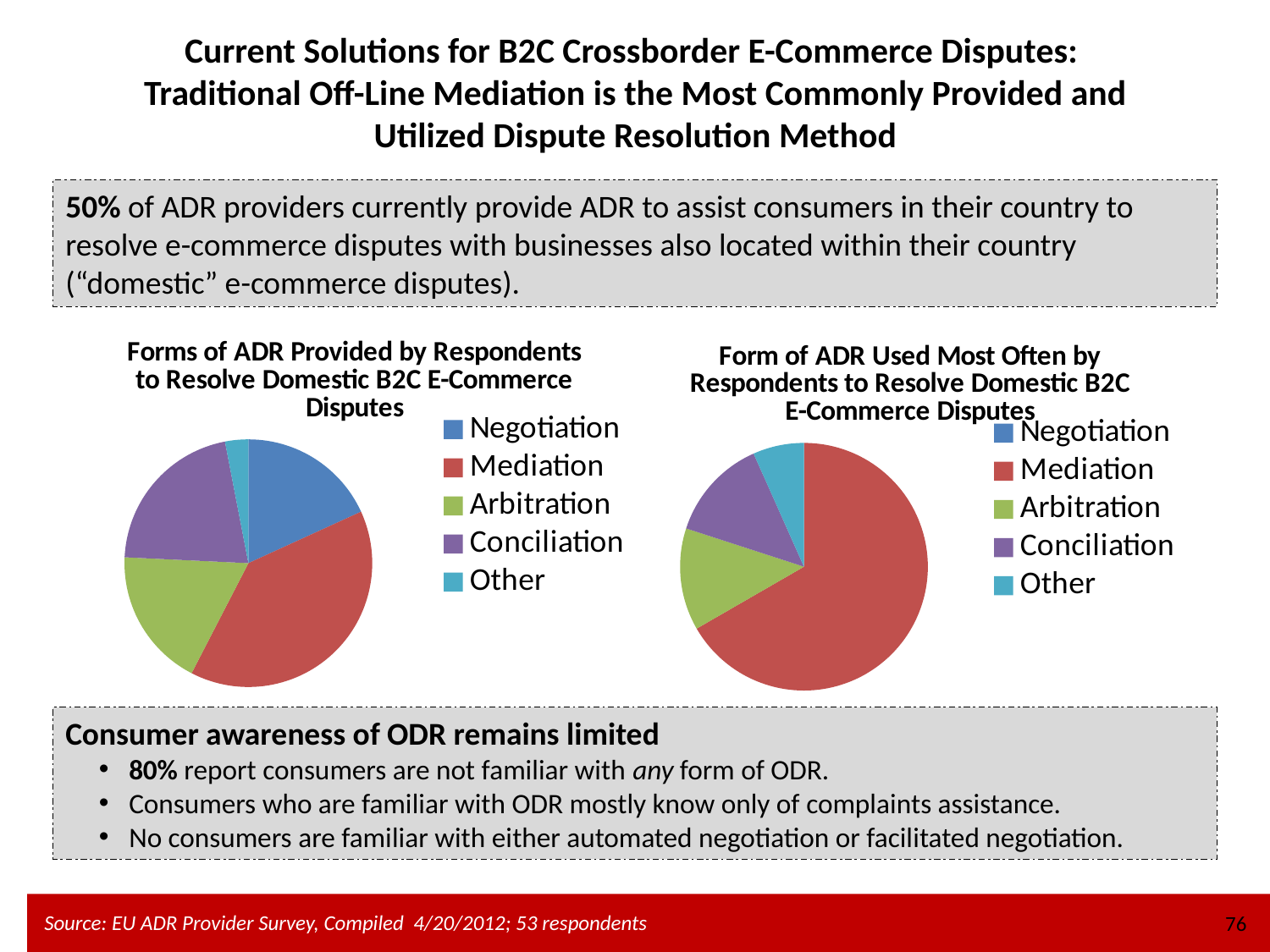
What type of chart is the 'Form of ADR Used Most Often by Respondents to Resolve Domestic B2C E-Commerce Disputes' chart? Pie chart How many charts are shown on the slide? 2 In the 'Form of ADR Used Most Often by Respondents' chart, is the Mediation slice more or less than half of the pie? more In the 'Form of ADR Used Most Often by Respondents' chart, which slice is larger, Mediation or Arbitration? Mediation What type of chart is the 'Forms of ADR Provided by Respondents to Resolve Domestic B2C E-Commerce Disputes' chart? Pie chart In the 'Forms of ADR Provided by Respondents' chart, which slice is larger, Mediation or Negotiation? Mediation In the 'Forms of ADR Provided by Respondents' chart, which form of ADR has the largest slice? Mediation In the 'Form of ADR Used Most Often by Respondents' chart, how many categories does the legend list? 5 In the 'Forms of ADR Provided by Respondents' chart, what colour represents Mediation? Red In the 'Forms of ADR Provided by Respondents' chart, which form of ADR has the smallest slice? Other In the 'Forms of ADR Provided by Respondents' chart, how many categories does the legend list? 5 In the 'Form of ADR Used Most Often by Respondents' chart, which form of ADR has the largest slice? Mediation